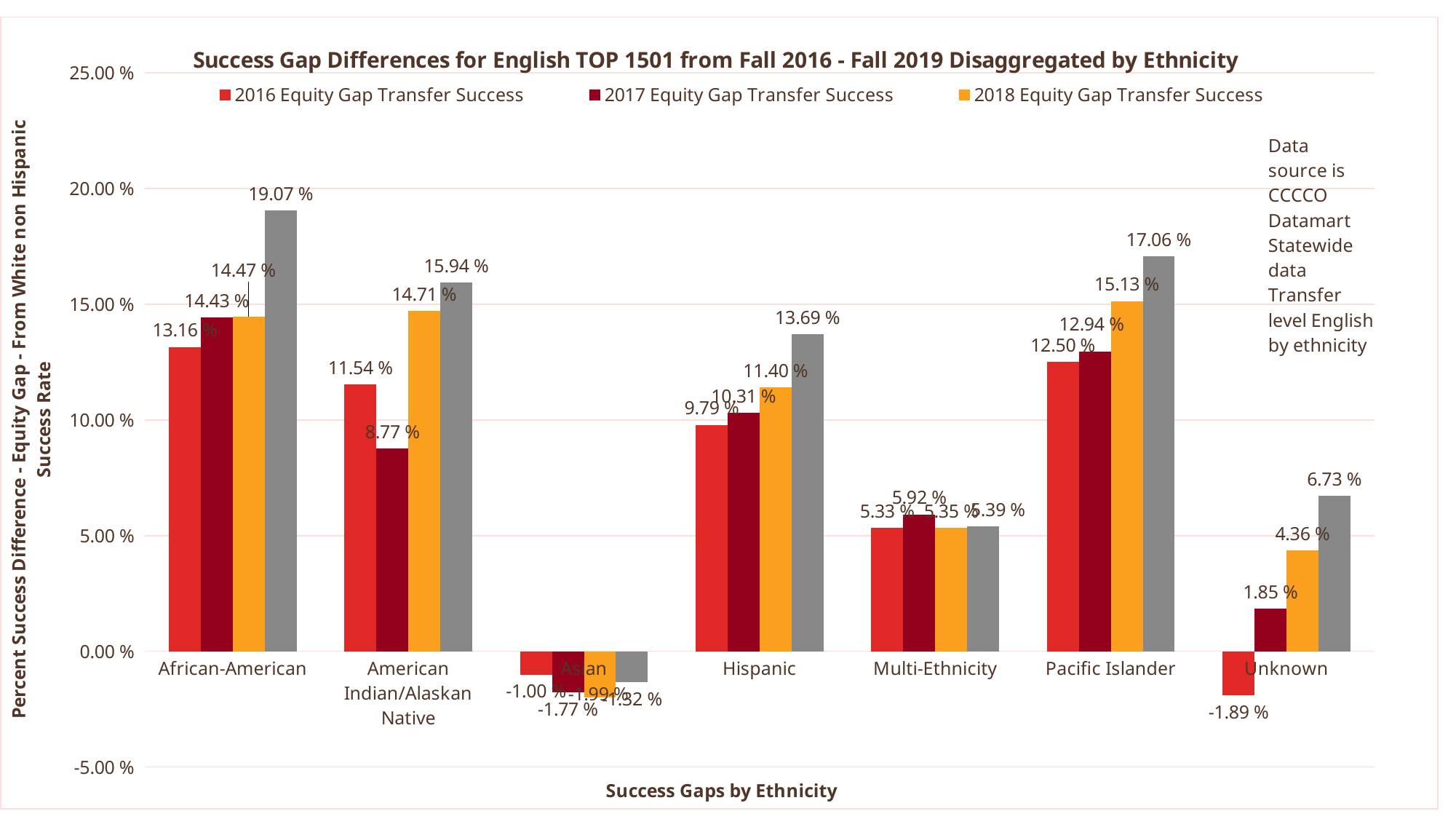
What is the 2018 Equity Gap Transfer Success value for Pacific Islander? 15.13 % What kind of chart is shown on the slide? Bar chart What is the 2016 Equity Gap Transfer Success value for Unknown? -1.89 % Which ethnicity has the lowest 2016 Equity Gap Transfer Success value? Unknown Is the 2017 Equity Gap Transfer Success value for Pacific Islander greater or less than 15.00 %? less How many ethnicity categories are shown on the x axis? 7 What is the 2016 Equity Gap Transfer Success value for African-American? 13.16 % How many series does the legend list? 3 For Unknown, how much higher is the 2018 Equity Gap Transfer Success value than the 2017 value? 2.51 % For Hispanic, which is larger: the 2017 or the 2018 Equity Gap Transfer Success value? 2018 Equity Gap Transfer Success Which ethnicity has the highest 2018 Equity Gap Transfer Success value? Pacific Islander What is the 2017 Equity Gap Transfer Success value for American Indian/Alaskan Native? 8.77 %